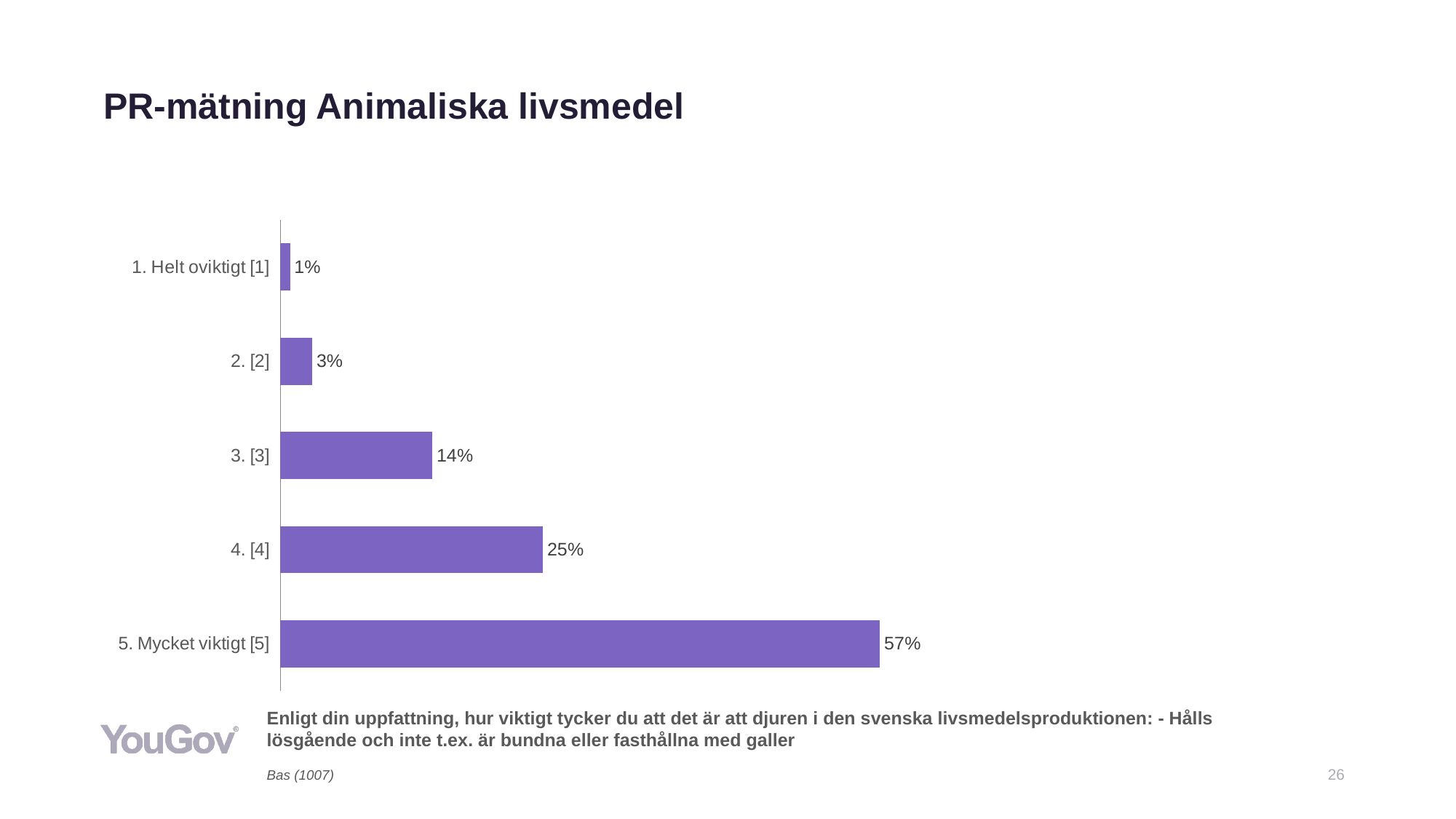
What is the difference between the values for "5. Mycket viktigt [5]" and "4. [4]"? 32% How many categories are shown in the chart? 5 Which is larger, the value for "2. [2]" or the value for "3. [3]"? 3. [3] What kind of chart is shown on the slide? Bar chart What is the value for "5. Mycket viktigt [5]"? 57% What is the base (Bas) size shown below the chart? 1007 What is the difference between the values for "3. [3]" and "2. [2]"? 11% What is the value for "1. Helt oviktigt [1]"? 1% Which category has the lowest value? 1. Helt oviktigt [1] Which category has the highest value? 5. Mycket viktigt [5] What is the value for "4. [4]"? 25% What is the value for "3. [3]"? 14%